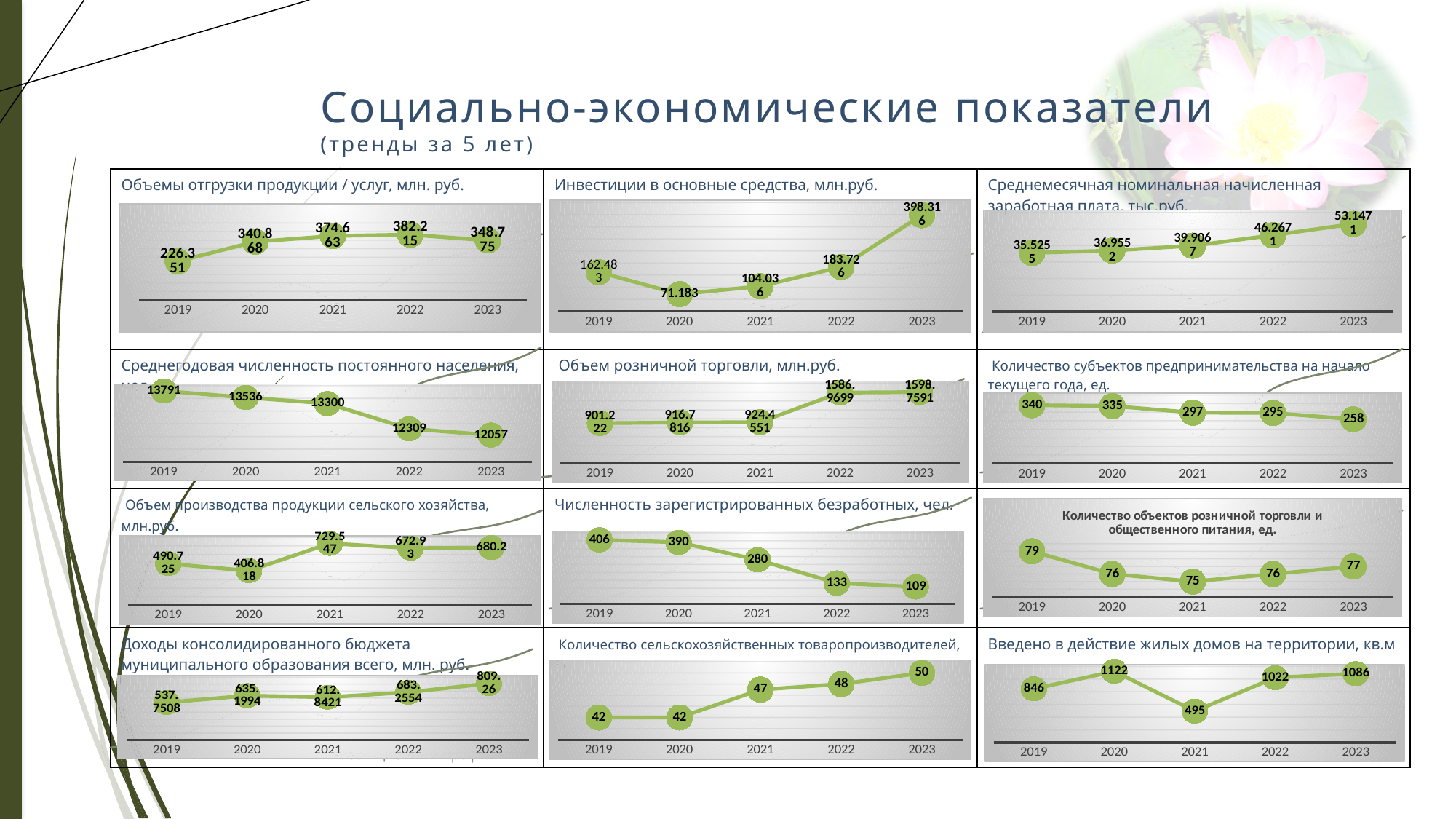
In the chart 'Введено в действие жилых домов на территории, кв.м', which year has the lowest value? 2021 In the chart 'Количество субъектов предпринимательства на начало текущего года, ед.', which year has the highest value? 2019 How many data points are plotted in the chart 'Количество объектов розничной торговли и общественного питания, ед.'? 5 What type of chart is used for 'Инвестиции в основные средства, млн.руб.'? Line chart In the chart 'Количество сельскохозяйственных товаропроизводителей', is the value for 2023 larger than the value for 2019? Yes, 2023 (50) is larger than 2019 (42) In the chart 'Численность зарегистрированных безработных, чел.', what is the difference between the 2019 and 2023 values? 297 In the chart 'Количество объектов розничной торговли и общественного питания, ед.', what is the difference between the 2019 and 2021 values? 4 In the chart 'Численность зарегистрированных безработных, чел.', what is the value for 2023? 109 How many charts are shown on the slide? 12 In the chart 'Среднегодовая численность постоянного населения', do the values rise or fall from 2019 to 2023? Fall In the chart 'Введено в действие жилых домов на территории, кв.м', what is the value for 2020? 1122 In the chart 'Среднегодовая численность постоянного населения', what is the value for 2019? 13791